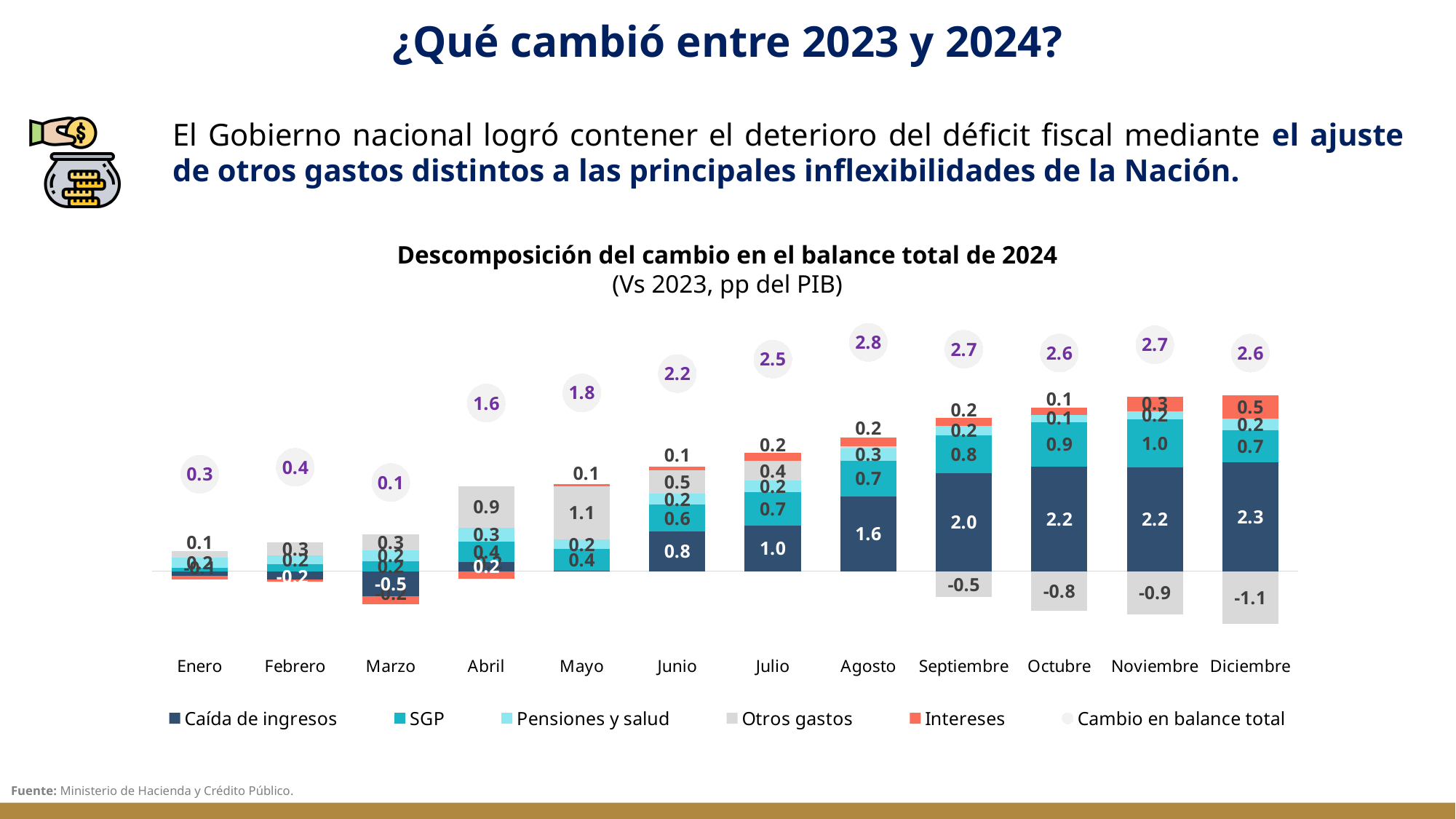
Which month has the highest 'Cambio en balance total' value? Agosto What is the 'Cambio en balance total' value for Agosto? 2.8 Which is larger, the 'Intereses' value for Diciembre or for Noviembre? Diciembre What is the difference between the 'Cambio en balance total' values for Diciembre and Enero? 2.3 Does the 'Cambio en balance total' value generally rise or fall from Enero to Agosto? Rise Which month has the lowest 'Cambio en balance total' value? Marzo What is the 'SGP' value for Octubre? 0.9 What is the 'Caída de ingresos' value for Diciembre? 2.3 How many entries does the chart's legend list? 6 What is the 'Otros gastos' value for Noviembre? -0.9 What kind of chart is shown on the slide? Stacked bar chart How many months are shown along the x axis of the chart? 12